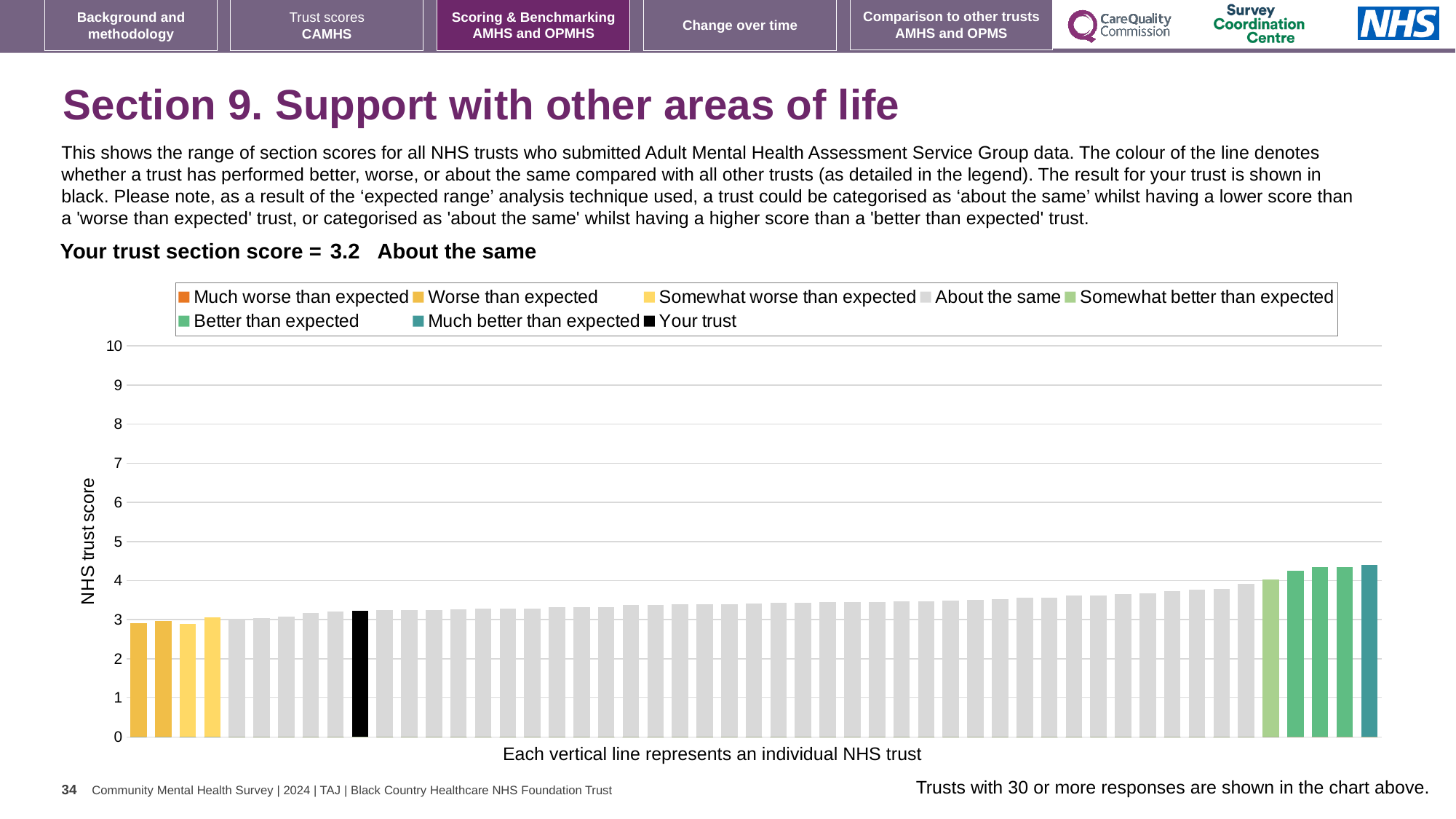
Is the value of the tallest bar greater or less than 4? greater Which category is your trust placed in for this section? About the same What is the section score for your trust shown on the slide? 3.2 What is the label on the vertical axis of the chart? NHS trust score How many bars in the chart are black? 1 Is the value for your trust greater or less than 3? greater What colour is the bar representing your trust? black Which is larger: the value for your trust (black bar) or the value of the leftmost bar? your trust What kind of chart is shown on the slide? bar chart Is the value of the leftmost bar greater or less than 3? less How many entries does the chart legend list? 8 Do the bar values rise or fall from left to right along the x axis? rise